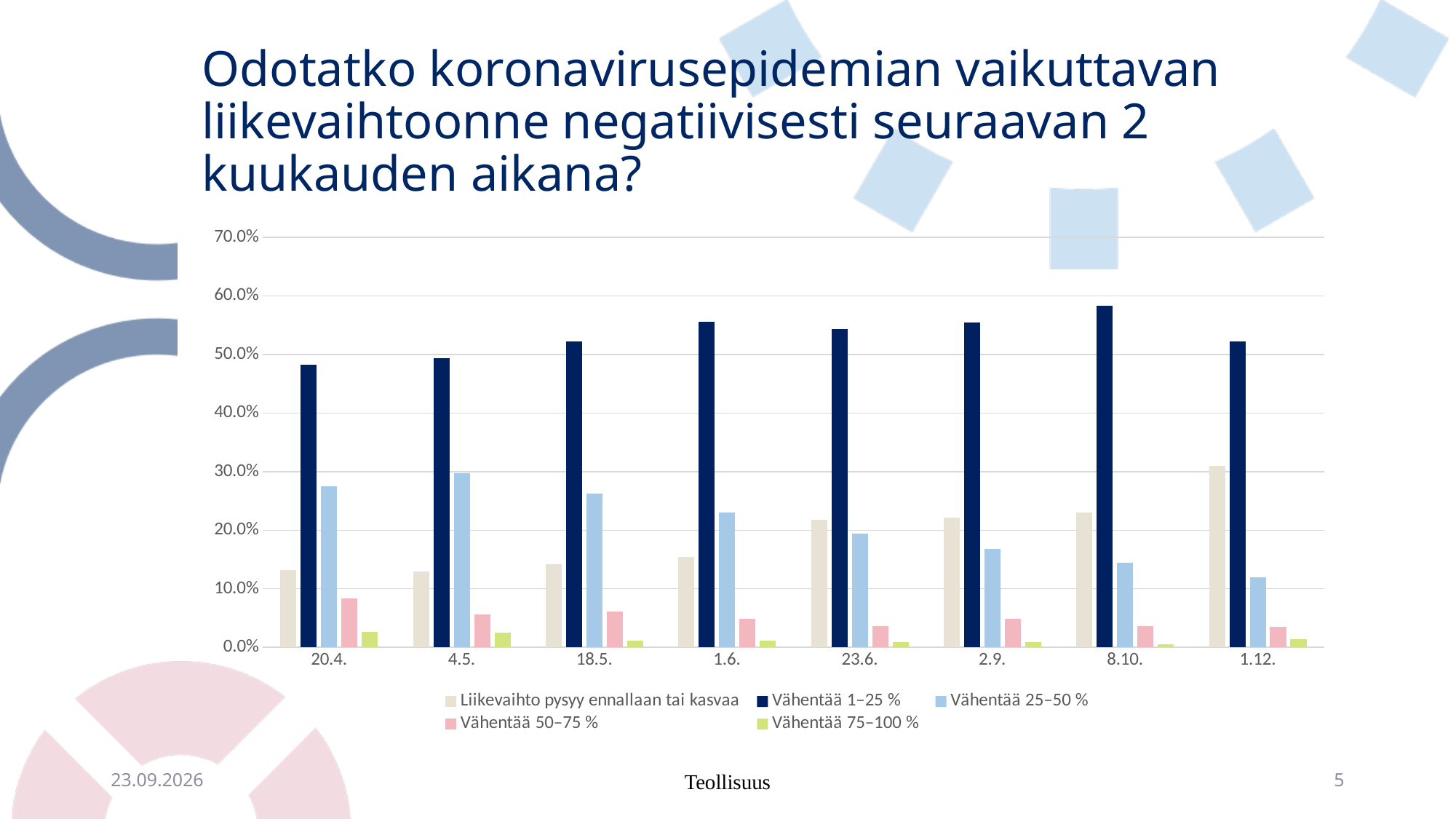
Which series is shown in dark blue in the legend? Vähentää 1–25 % Is the value for 'Vähentää 1–25 %' on 8.10. greater or less than 50.0%? greater How many dates (categories) are shown on the x axis? 8 What kind of chart is shown on the slide? Bar chart Is the value for 'Vähentää 25–50 %' on 1.12. greater or less than 20.0%? less On which date is the value for 'Liikevaihto pysyy ennallaan tai kasvaa' highest? 1.12. On which date is the value for 'Vähentää 25–50 %' highest? 4.5. Between 4.5. and 1.12., does the value for 'Vähentää 25–50 %' rise or fall? Fall How many series does the legend list? 5 On 20.4., which is larger: 'Vähentää 1–25 %' or 'Vähentää 25–50 %'? Vähentää 1–25 % On which date is the value for 'Vähentää 1–25 %' highest? 8.10. On which date is the value for 'Vähentää 1–25 %' lowest? 20.4.